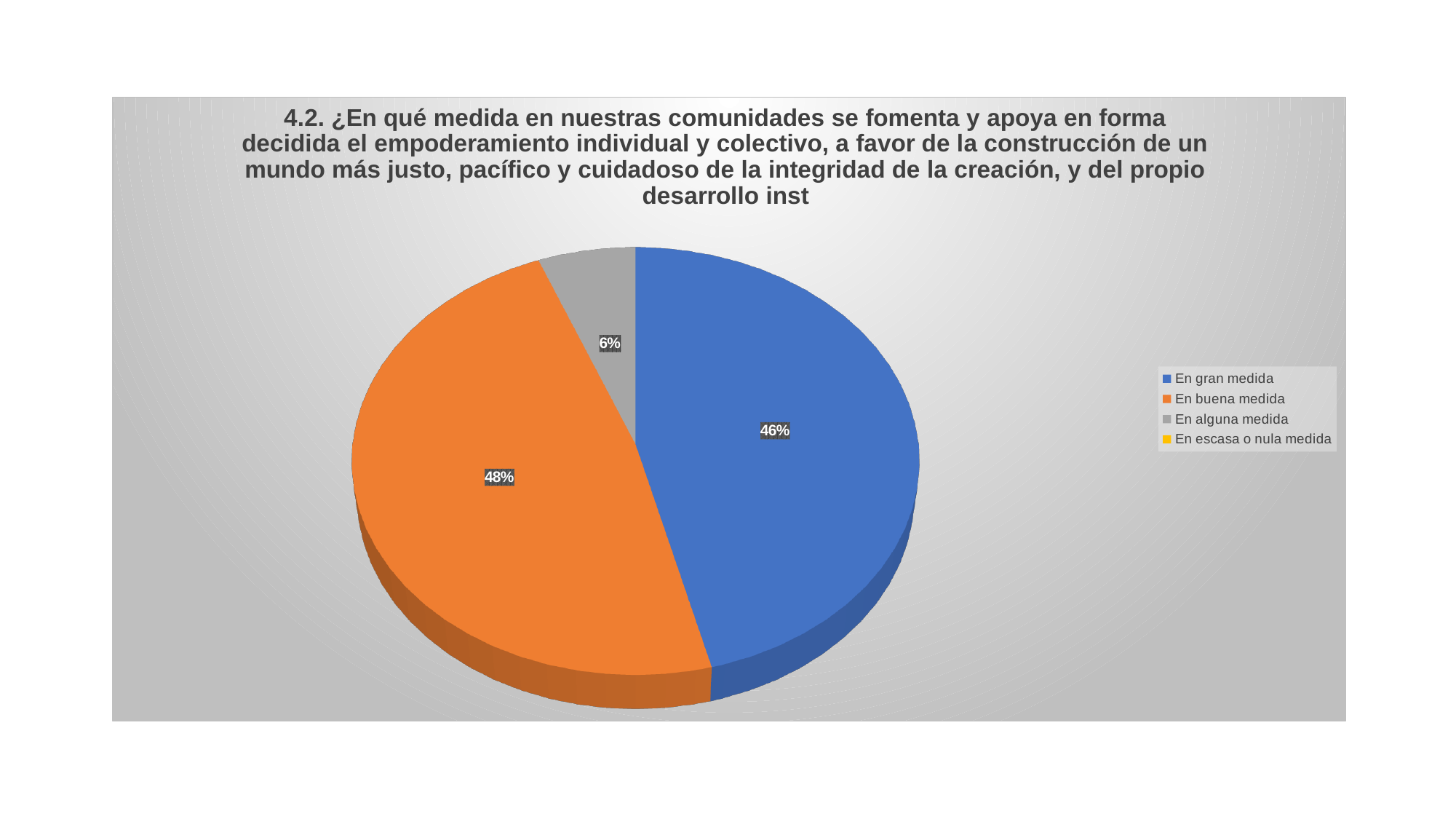
What kind of chart is shown on the slide? Pie chart Which labelled slice is the smallest in the pie? En alguna medida What share of the pie does "En alguna medida" represent? 6% What share of the pie does "En gran medida" represent? 46% How many entries does the legend list? 4 Which is larger, the slice for "En gran medida" or the slice for "En buena medida"? En buena medida How many slices with data labels are shown in the pie? 3 What is the combined share of "En gran medida" and "En buena medida"? 94% What share of the pie does "En buena medida" represent? 48% What colour is the slice for "En buena medida"? Orange Which category has the largest slice of the pie? En buena medida What is the difference between the "En buena medida" share and the "En gran medida" share? 2 percentage points